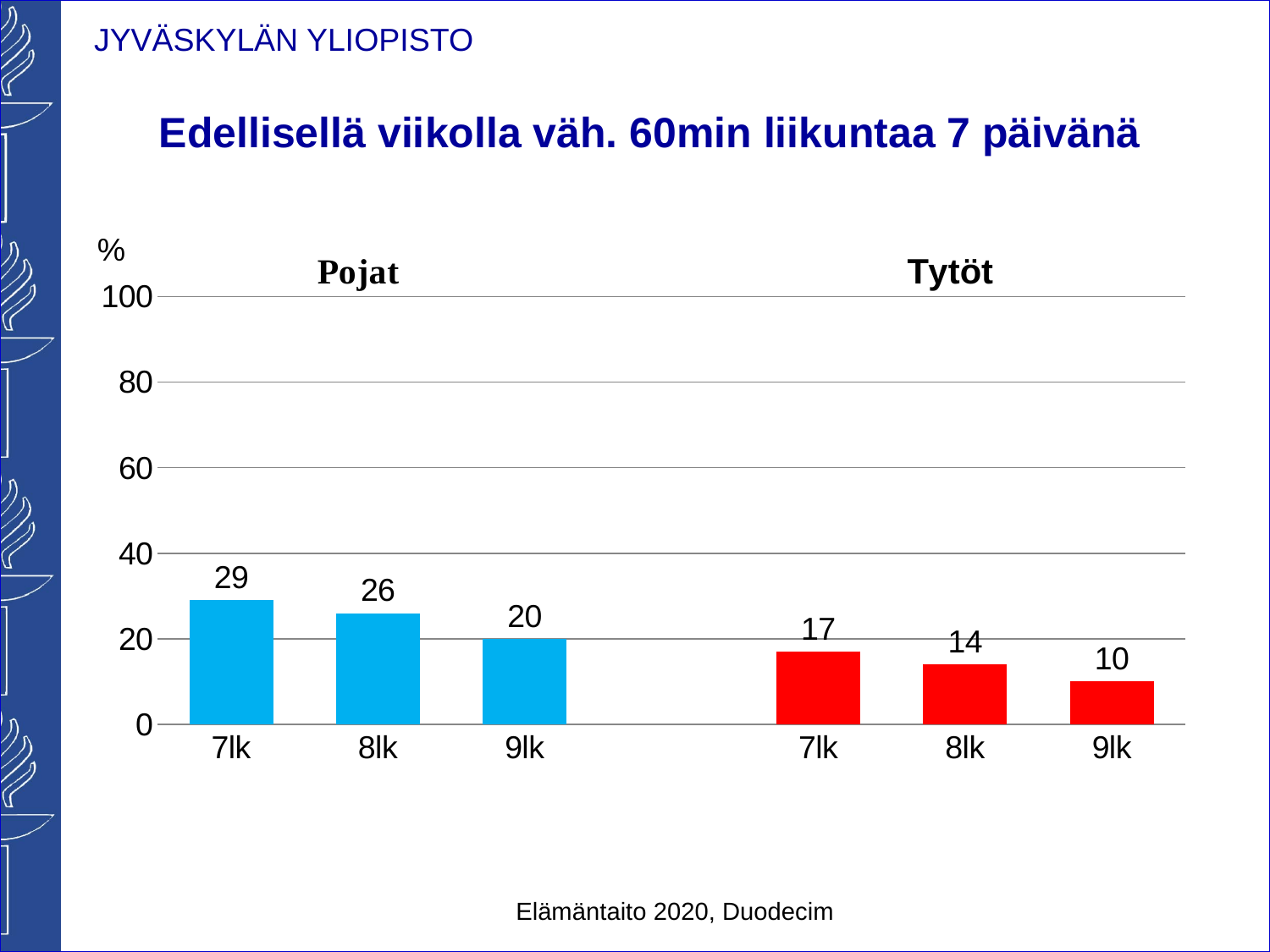
What is the difference between Pojat 7lk and Tytöt 7lk? 12 What is the value for Tytöt 8lk? 14 What is the difference between Pojat 8lk and Pojat 9lk? 6 What is the value for Tytöt 9lk? 10 Which bar has the highest value on the chart? Pojat 7lk Which is larger, Pojat 9lk or Tytöt 7lk? Pojat 9lk What kind of chart is shown on the slide? bar chart Which bar has the lowest value on the chart? Tytöt 9lk What is the value for Pojat 7lk? 29 How many bars are plotted on the chart? 6 Do the values for Tytöt rise or fall from 7lk to 9lk? fall What is the value for Pojat 9lk? 20